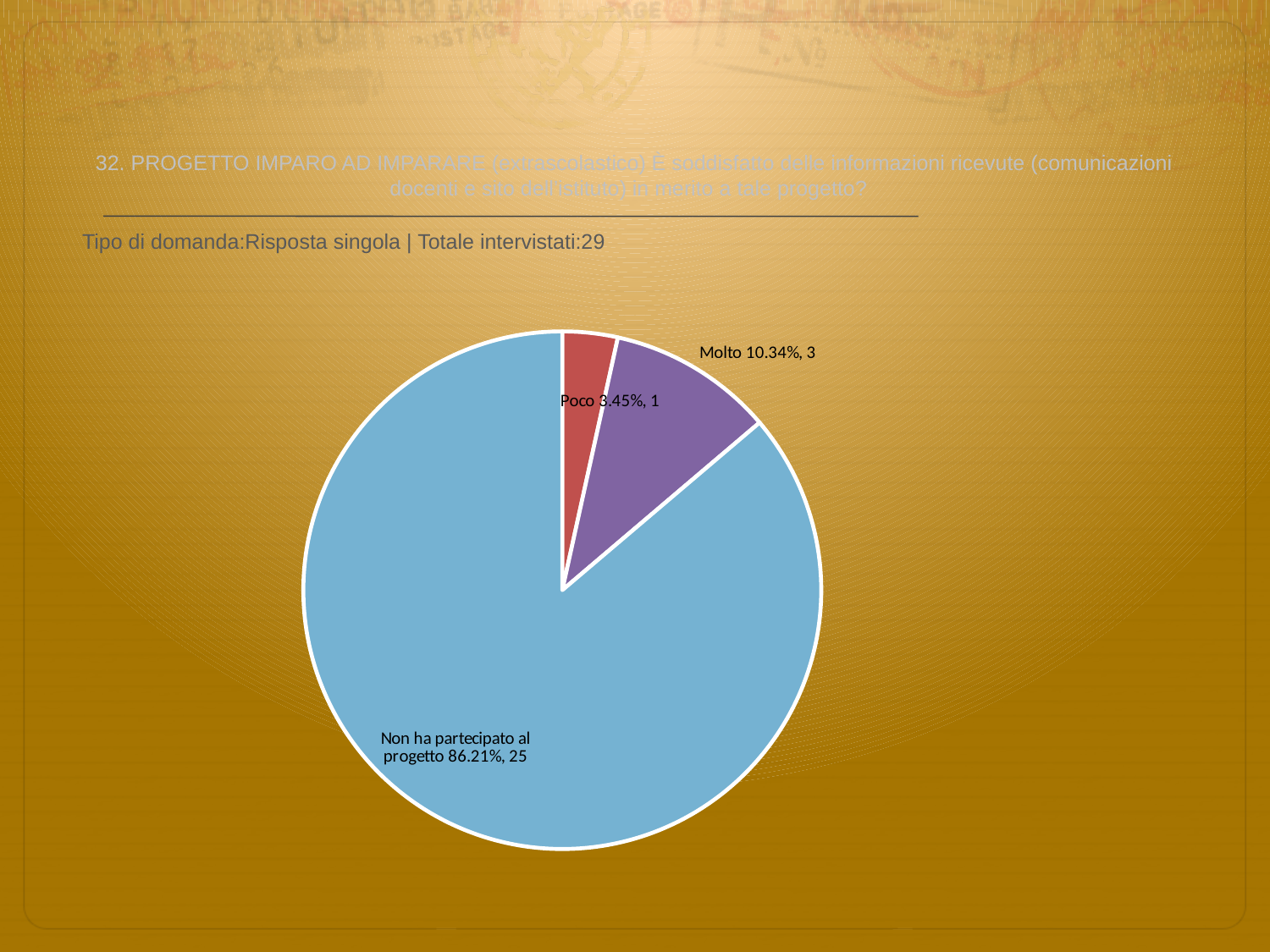
Which has more respondents, 'Molto' or 'Poco'? Molto What percentage share does the 'Non ha partecipato al progetto' slice have? 86.21% What percentage share does the 'Poco' slice have? 3.45% What percentage share does the 'Molto' slice have? 10.34% How many respondents chose 'Poco'? 1 What is the difference in respondent count between 'Non ha partecipato al progetto' and 'Molto'? 22 What kind of chart is shown on the slide? pie chart How many respondents chose 'Molto'? 3 Which slice is the largest? Non ha partecipato al progetto How many respondents are in the 'Non ha partecipato al progetto' slice? 25 How many slices does the pie chart have? 3 Which slice is the smallest? Poco